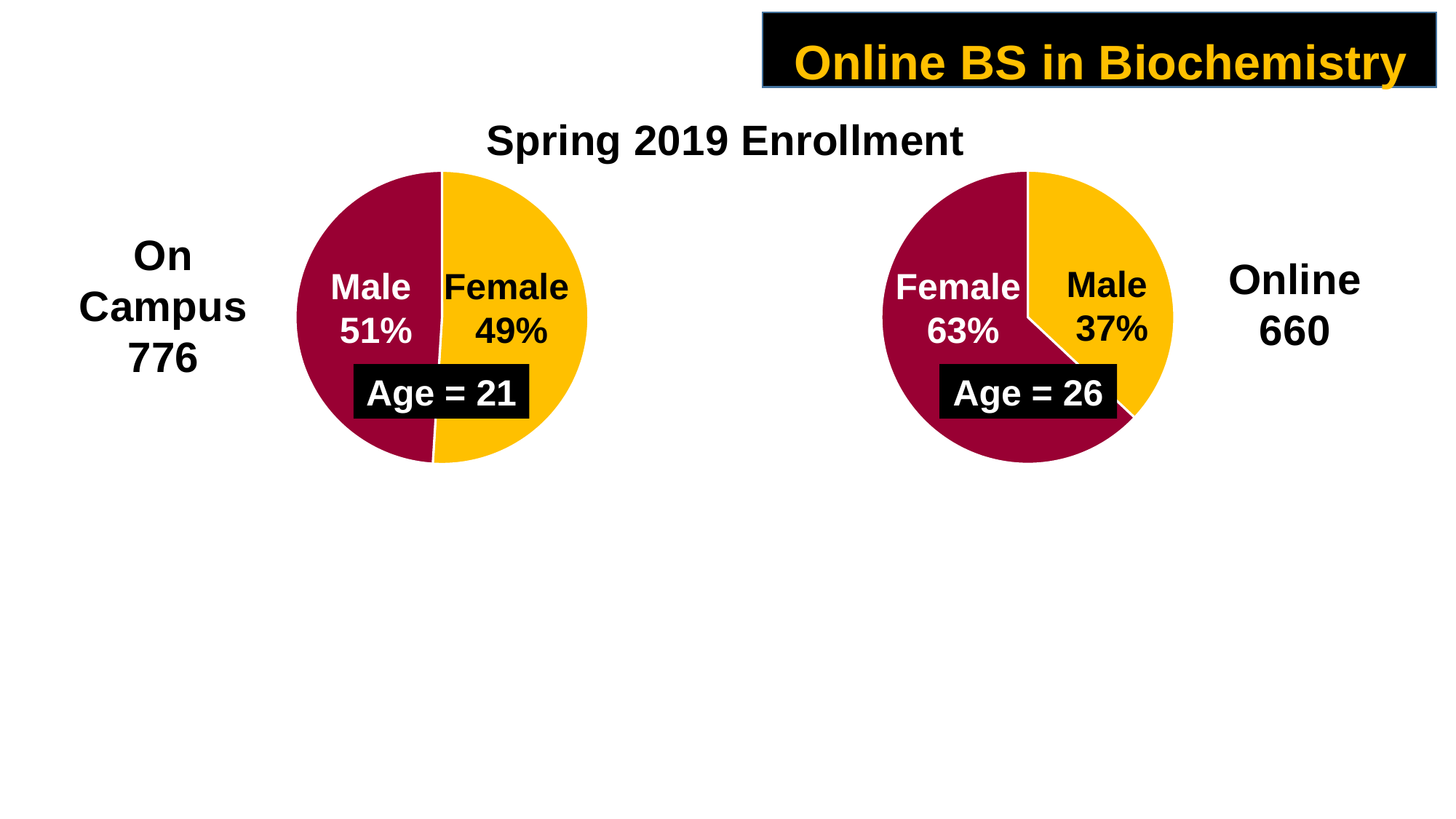
In the Online pie chart, what is the difference between the Female and Male percentages? 26% In the On Campus pie chart, what is the difference between the Male and Female percentages? 2% In the On Campus pie chart, what percentage of students are female? 49% In the Online pie chart, what percentage of students are female? 63% In the Online pie chart, which slice is larger, Female or Male? Female In the On Campus pie chart, what percentage of students are male? 51% What is the total enrollment shown for the Online group? 660 How many slices does the Online pie chart have? 2 What type of chart is used to show the On Campus enrollment? Pie chart In the Online pie chart, what percentage of students are male? 37% What is the total enrollment shown for the On Campus group? 776 What is the title shown above the two pie charts? Spring 2019 Enrollment